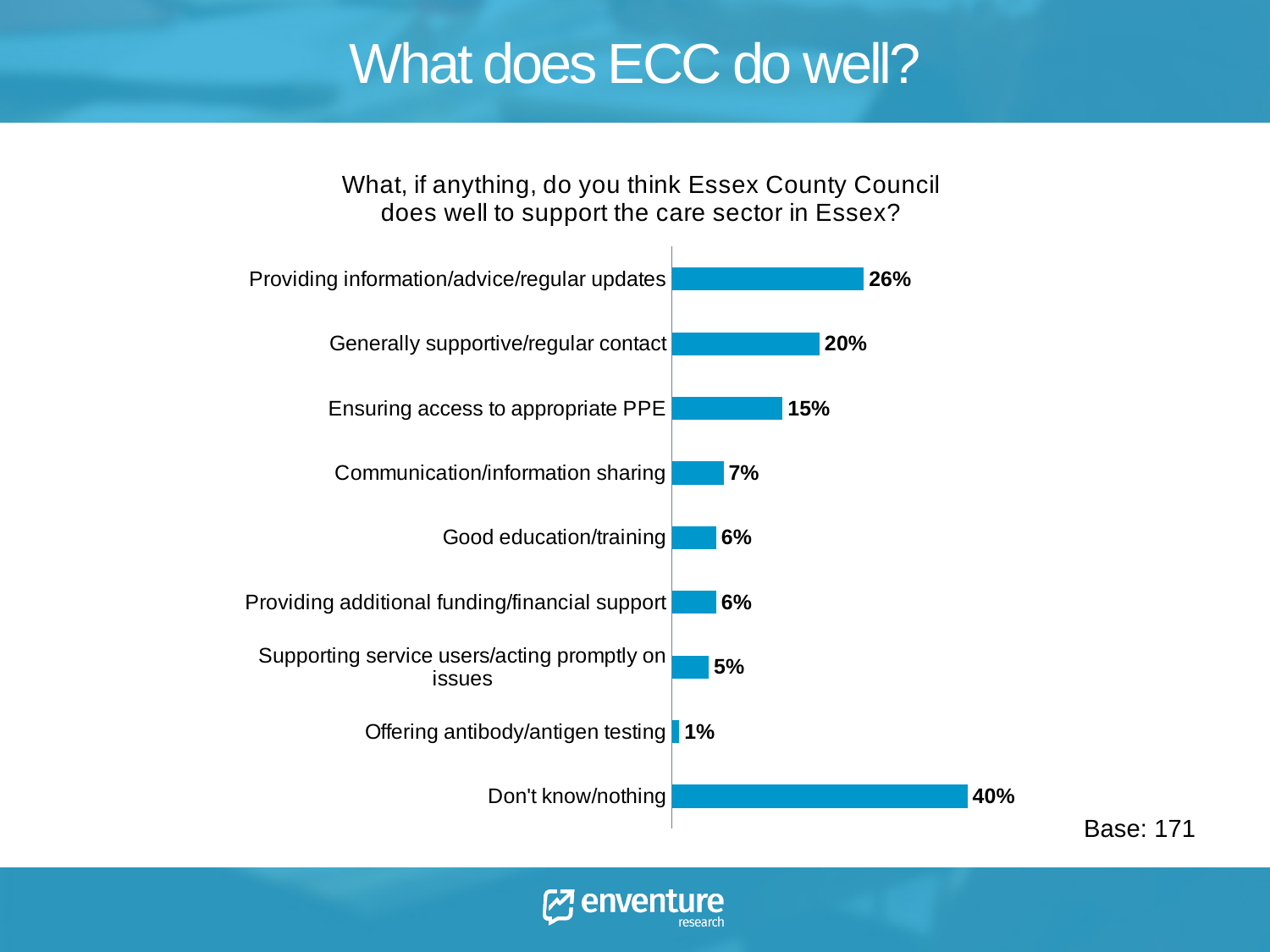
What kind of chart is shown on the slide? Bar chart What percentage of respondents said ECC does well at providing information/advice/regular updates? 26% What is the value for 'Ensuring access to appropriate PPE'? 15% Which category has the lowest value? Offering antibody/antigen testing What is the difference between 'Don't know/nothing' and 'Ensuring access to appropriate PPE'? 25% What is the base (number of respondents) shown for the chart? 171 What percentage answered 'Don't know/nothing'? 40% Which category has the highest value? Don't know/nothing Which is larger: 'Communication/information sharing' or 'Supporting service users/acting promptly on issues'? Communication/information sharing What is the difference between 'Providing information/advice/regular updates' and 'Generally supportive/regular contact'? 6% How many categories are shown in the chart? 9 What is the value for 'Offering antibody/antigen testing'? 1%